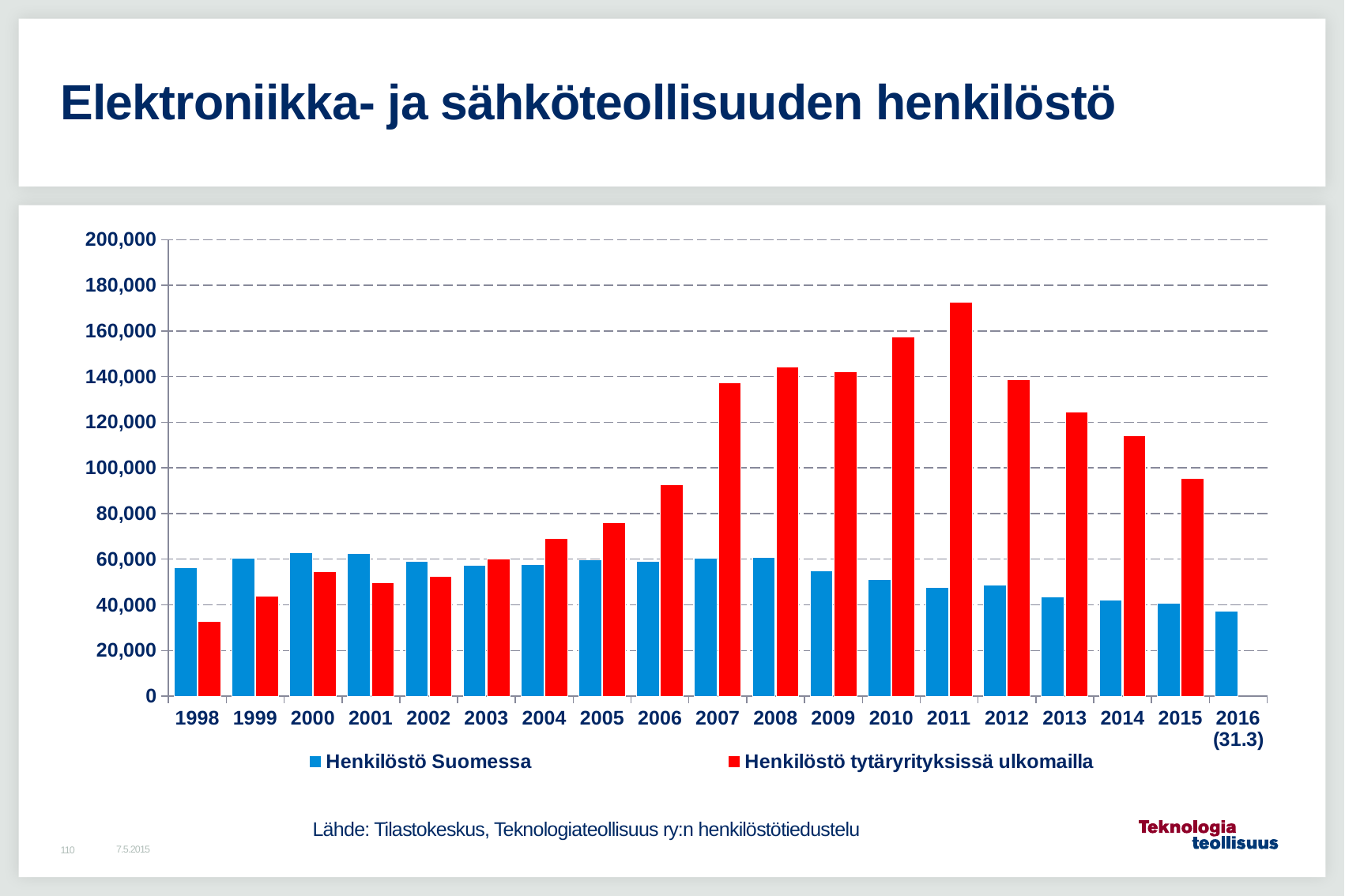
In which year is the value for Henkilöstö Suomessa lowest? 2016 (31.3) Is the value for Henkilöstö tytäryrityksissä ulkomailla in 2011 greater or less than 160,000? greater In 1998, which series has the larger value: Henkilöstö Suomessa or Henkilöstö tytäryrityksissä ulkomailla? Henkilöstö Suomessa Is the value for Henkilöstö tytäryrityksissä ulkomailla in 2015 greater or less than 100,000? less What kind of chart is shown on the slide? Bar chart What is the title of the chart on the slide? Elektroniikka- ja sähköteollisuuden henkilöstö Is the value for Henkilöstö Suomessa in 1998 greater or less than 60,000? less Does the value for Henkilöstö tytäryrityksissä ulkomailla rise or fall from 2011 to 2015? Fall How many years (categories) are shown on the x axis? 19 In which year is the value for Henkilöstö tytäryrityksissä ulkomailla lowest? 1998 In which year is the value for Henkilöstö tytäryrityksissä ulkomailla highest? 2011 How many series does the legend list? 2